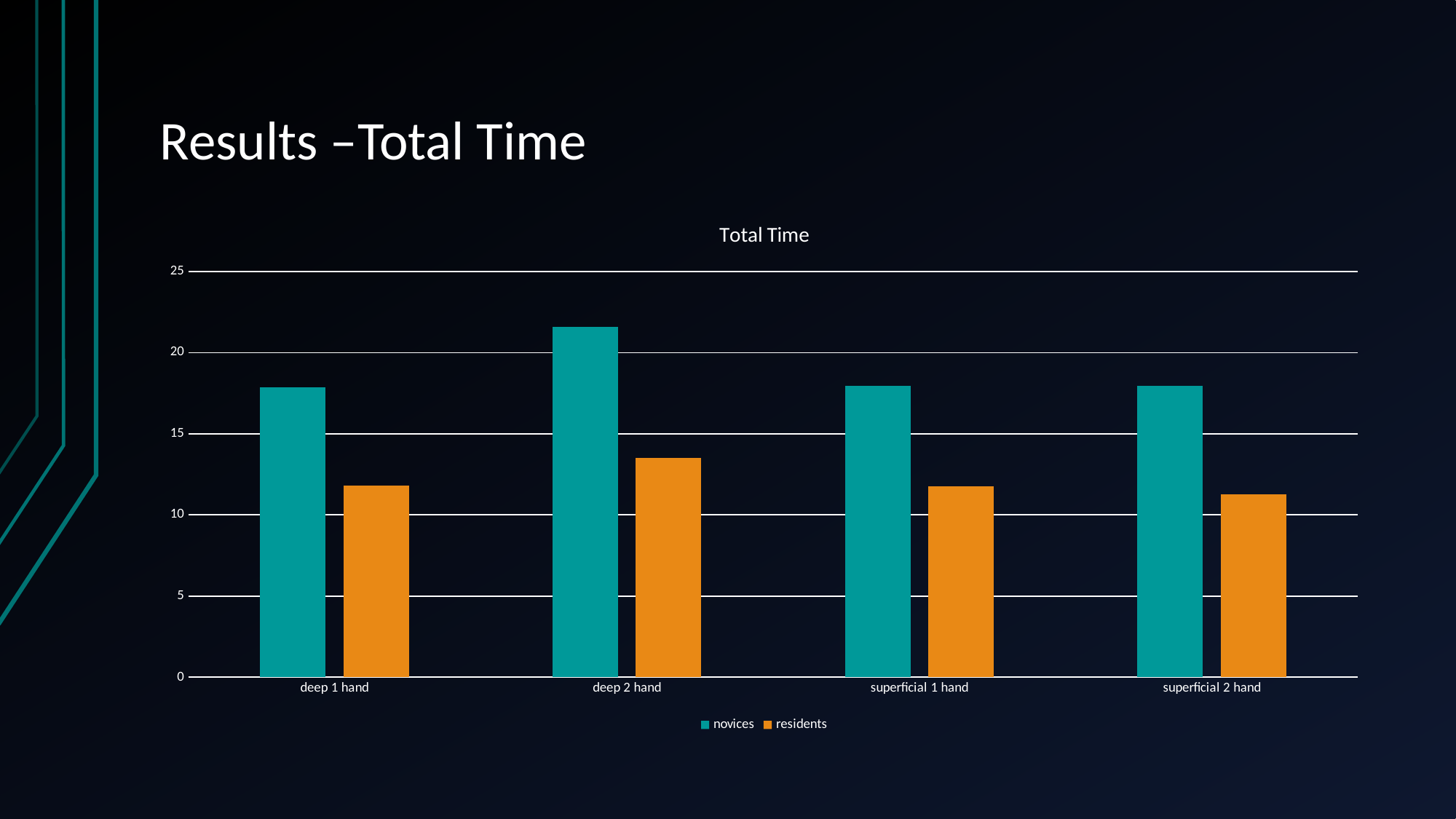
Which category has the highest value for residents? deep 2 hand What kind of chart is shown on the slide? bar chart Is the value for residents in deep 2 hand greater or less than 15? less How many series does the legend list? 2 Which category has the highest value for novices? deep 2 hand Is the value for novices in deep 2 hand greater or less than 20? greater Which series is shown in orange? residents Is the value for residents in superficial 2 hand greater or less than 10? greater What is the title of the chart? Total Time In the superficial 1 hand category, which is larger: novices or residents? novices How many categories are shown on the x axis? 4